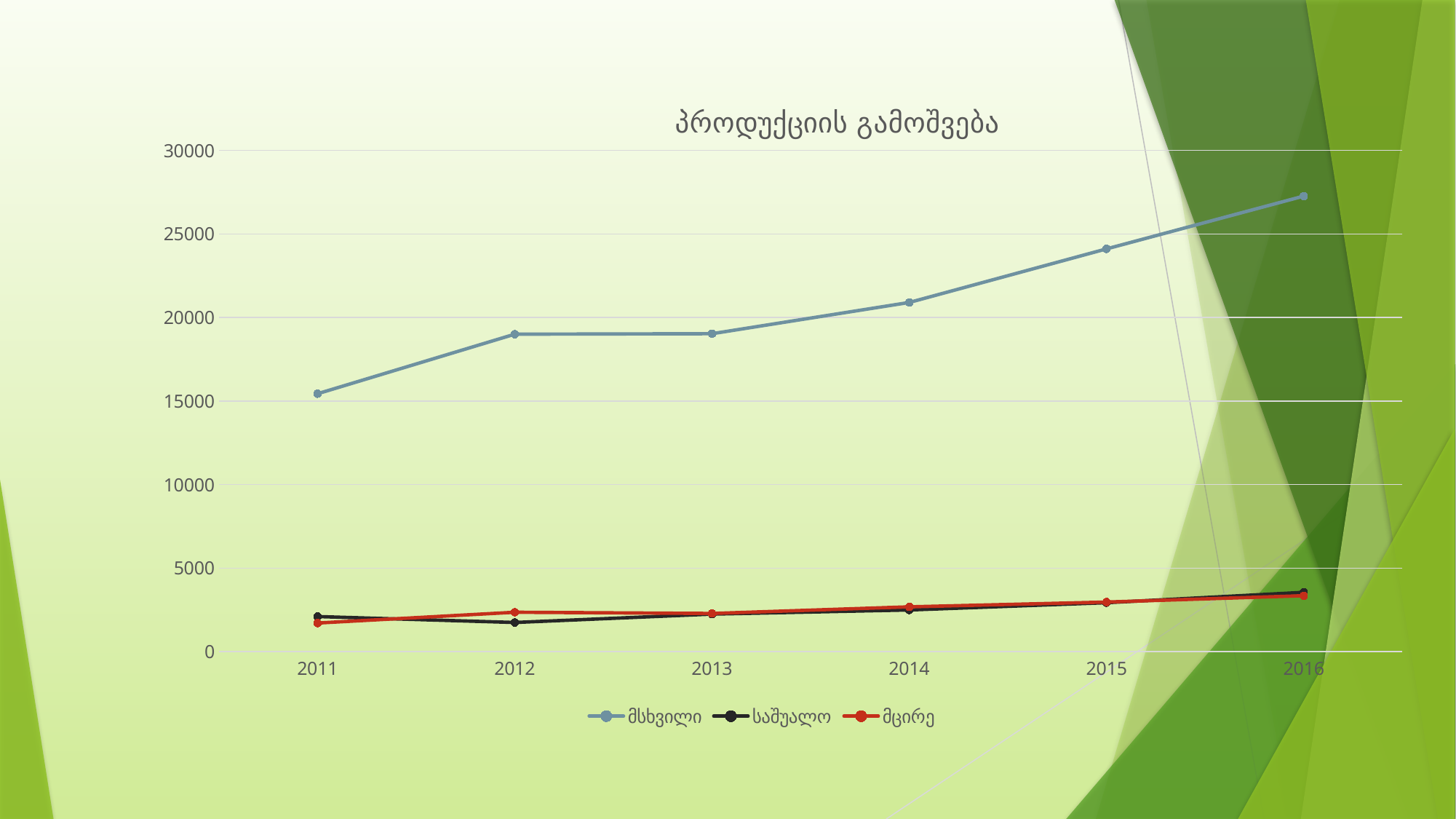
Does the value for მსხვილი rise or fall from 2011 to 2016? rise What colour is the line for მცირე? red What is the title of the chart? პროდუქციის გამოშვება In which year is the value for მსხვილი highest? 2016 Is the value for მსხვილი in 2016 greater or less than 25000? greater In 2016, which series has the larger value, მსხვილი or საშუალო? მსხვილი Is the value for მსხვილი in 2011 greater or less than 20000? less Is the value for საშუალო in 2016 greater or less than 5000? less How many series does the legend list? 3 How many years are shown on the x axis? 6 What kind of chart is shown on the slide? line chart In which year is the value for მსხვილი lowest? 2011